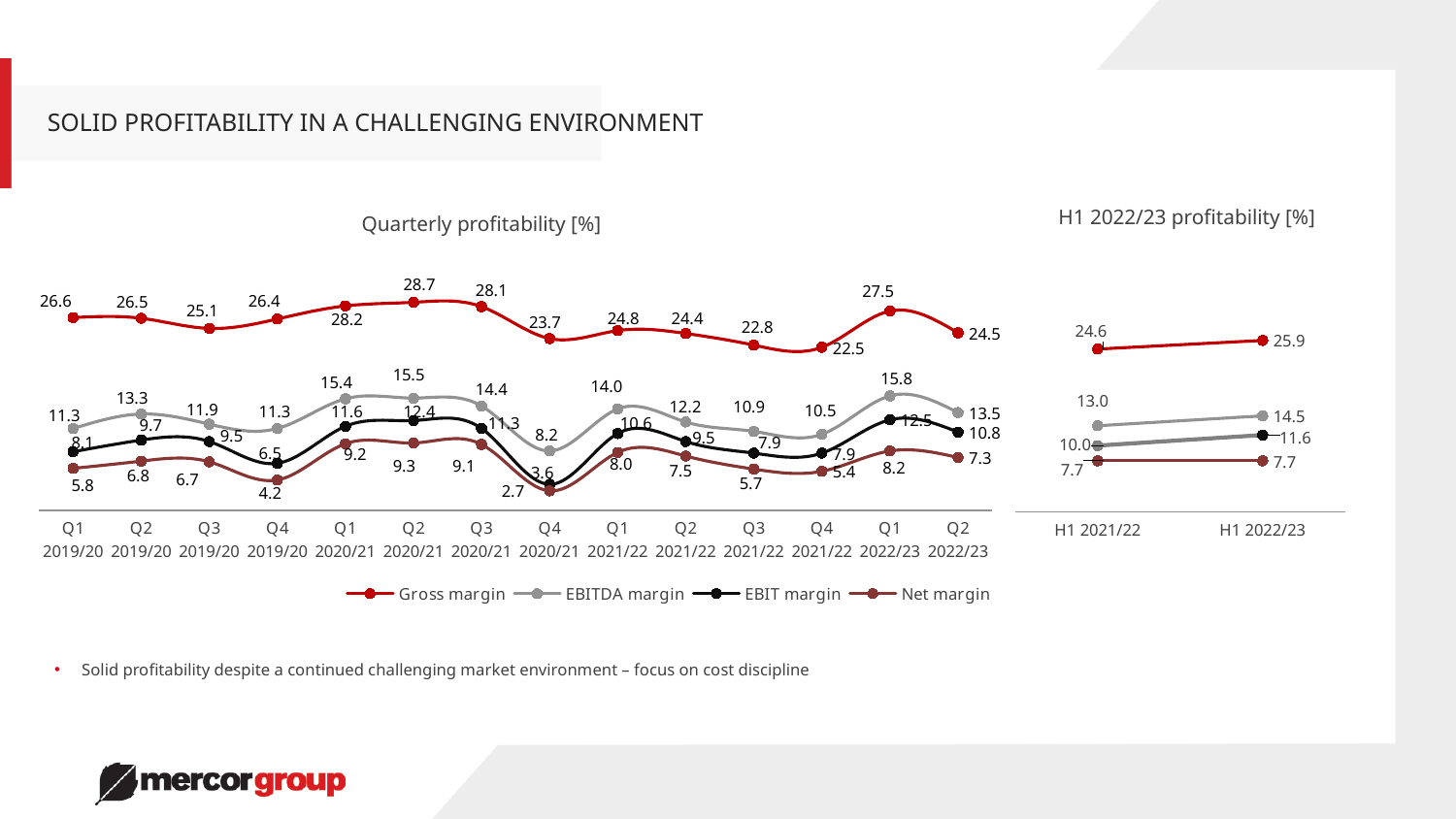
What type of chart is the Quarterly profitability chart? Line chart How many series does the legend of the Quarterly profitability chart list? 4 In the Quarterly profitability chart, what is the net margin for Q4 2020/21? 2.7 In the H1 2022/23 profitability chart, does the grey line rise or fall from H1 2021/22 to H1 2022/23? Rise In the Quarterly profitability chart, what is the gross margin for Q2 2020/21? 28.7 How many quarters are shown on the x axis of the Quarterly profitability chart? 14 In the Quarterly profitability chart, in which quarter is the EBIT margin lowest? Q4 2020/21 In the Quarterly profitability chart, in which quarter is the gross margin highest? Q2 2020/21 In the Quarterly profitability chart, what is the difference between the gross margin in Q1 2022/23 and Q2 2022/23? 3.0 In the H1 2022/23 profitability chart, what is the value of the top (red) line for H1 2022/23? 25.9 In the Quarterly profitability chart, is the EBITDA margin higher in Q2 2020/21 or in Q4 2020/21? Q2 2020/21 In the Quarterly profitability chart, what is the EBITDA margin for Q1 2022/23? 15.8